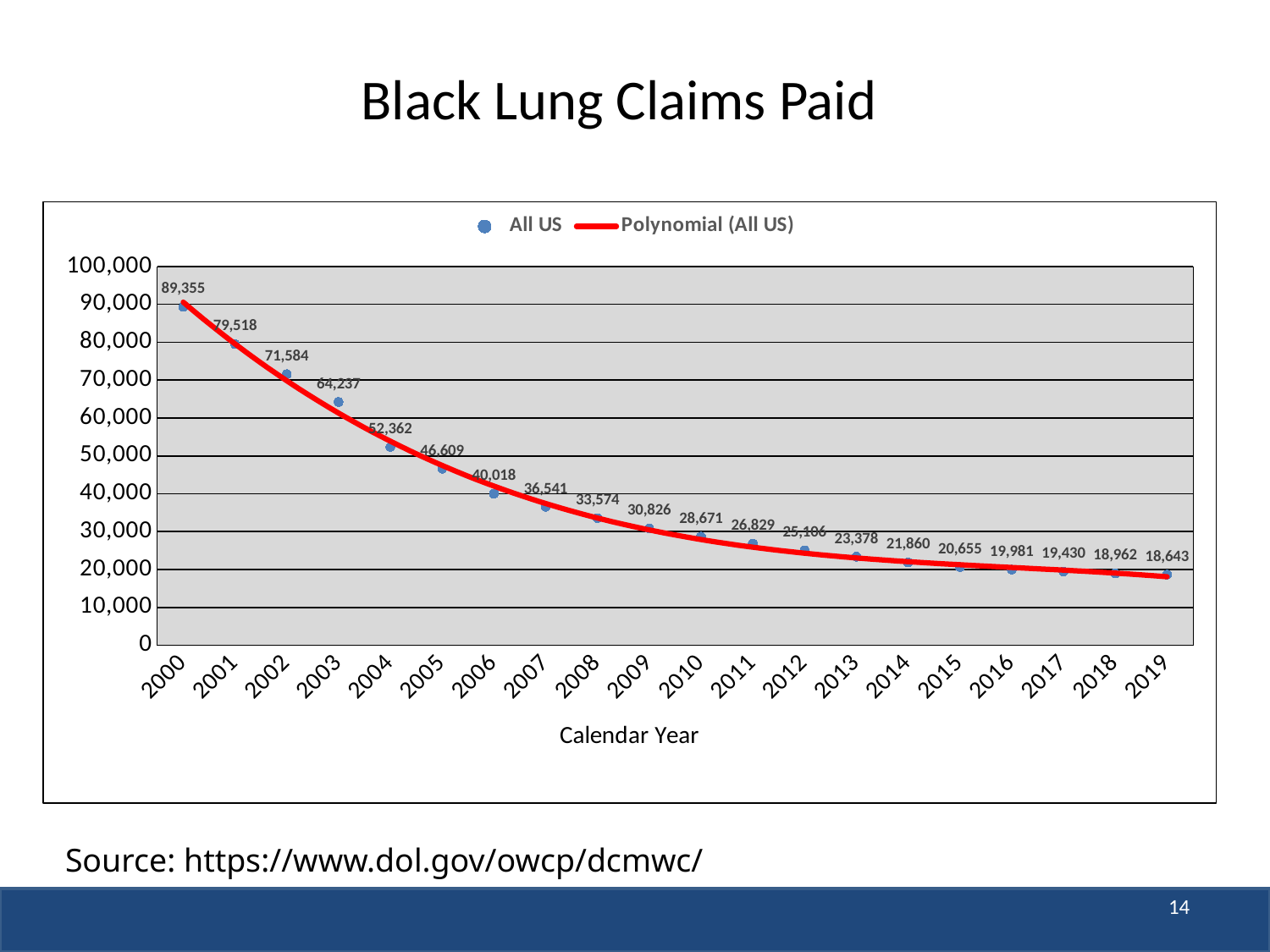
What is the difference between the values for 2000 and 2001? 9,837 What is the value for 2006? 40,018 Do the values rise or fall from 2000 to 2019? fall What is the value for 2019? 18,643 Which year has the lowest value? 2019 Which year has the highest value? 2000 What is the value for 2000? 89,355 What is the value for 2014? 21,860 How many entries does the legend list? 2 Which is larger, the value for 2005 or the value for 2008? 2005 Is the value for 2004 greater or less than 50,000? greater How many years are plotted on the x axis? 20